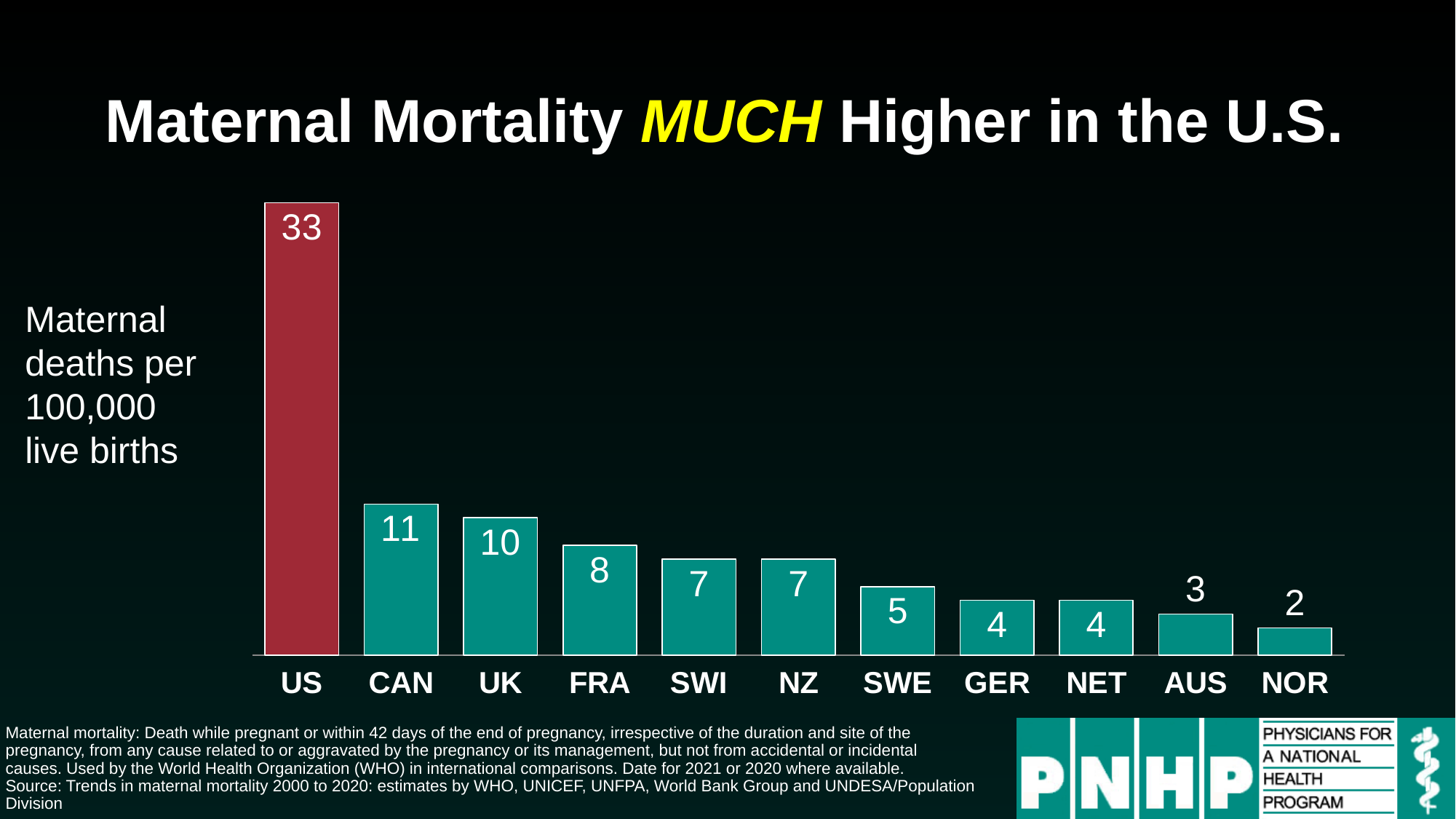
What is the difference between the US value and the CAN value? 22 What kind of chart is shown on the slide? Bar chart Which country has the highest maternal mortality on the chart? US What unit is the chart measured in, according to the label on the left? Maternal deaths per 100,000 live births How many countries are shown on the chart? 11 Do the values generally rise or fall from left to right across the chart? Fall What is the maternal mortality value for the US? 33 What is the difference between the UK value and the NOR value? 8 Which has a higher maternal mortality value, FRA or GER? FRA What is the maternal mortality value for SWE? 5 What is the maternal mortality value for CAN? 11 Which country has the lowest maternal mortality on the chart? NOR